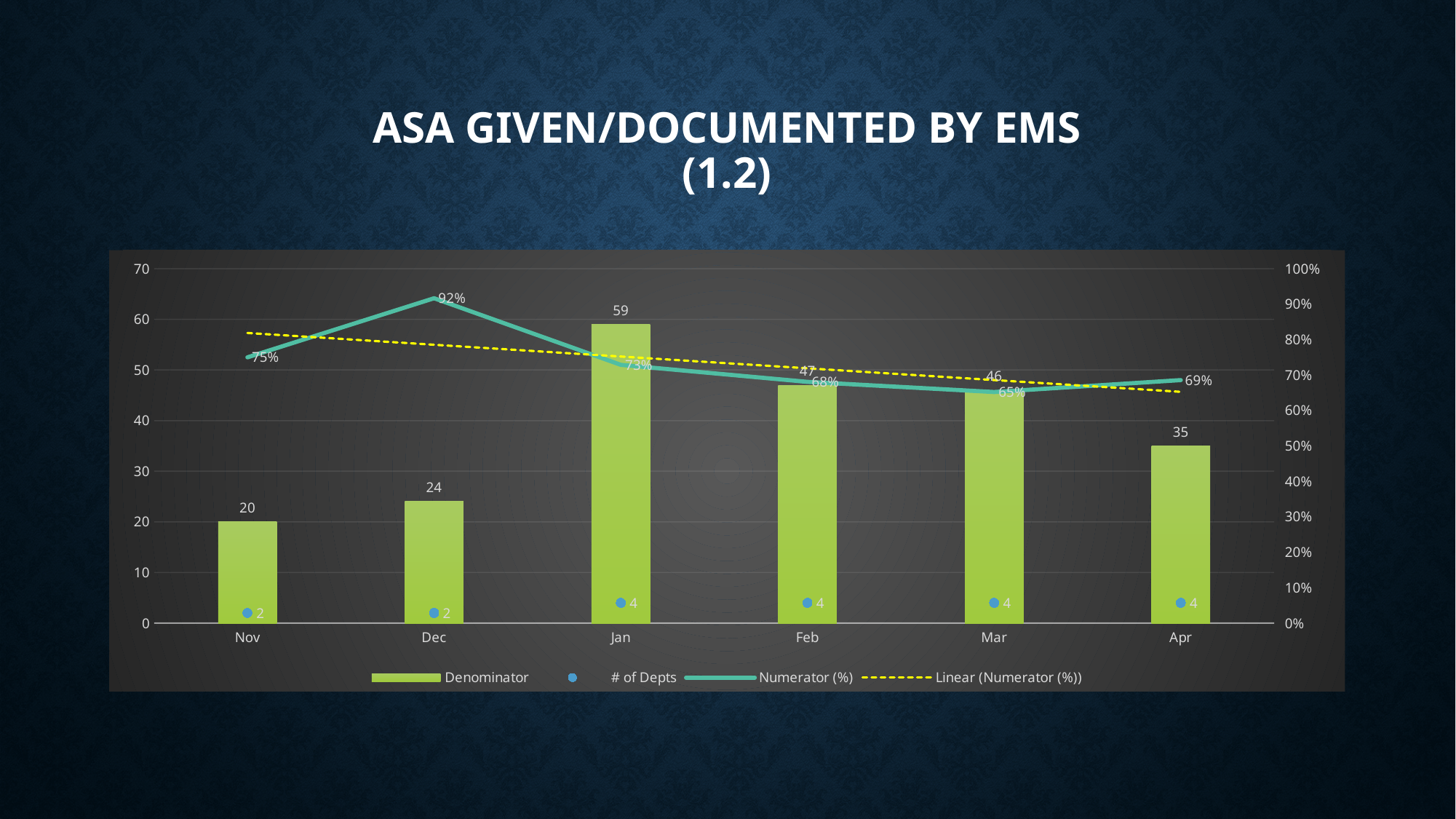
What is the title of the chart? ASA GIVEN/DOCUMENTED BY EMS (1.2) Does the Denominator value rise or fall from Nov to Jan? rise What is the # of Depts value for Nov? 2 What is the Numerator (%) value for Dec? 92% What is the difference between the Denominator values for Jan and Apr? 24 Which month has the highest Denominator value? Jan How many series does the legend list? 4 Which month has the lowest Numerator (%) value? Mar What is the Numerator (%) value for Apr? 69% What is the Denominator value for Jan? 59 How many months are shown on the x axis? 6 Which is larger, the Denominator value for Feb or for Mar? Feb